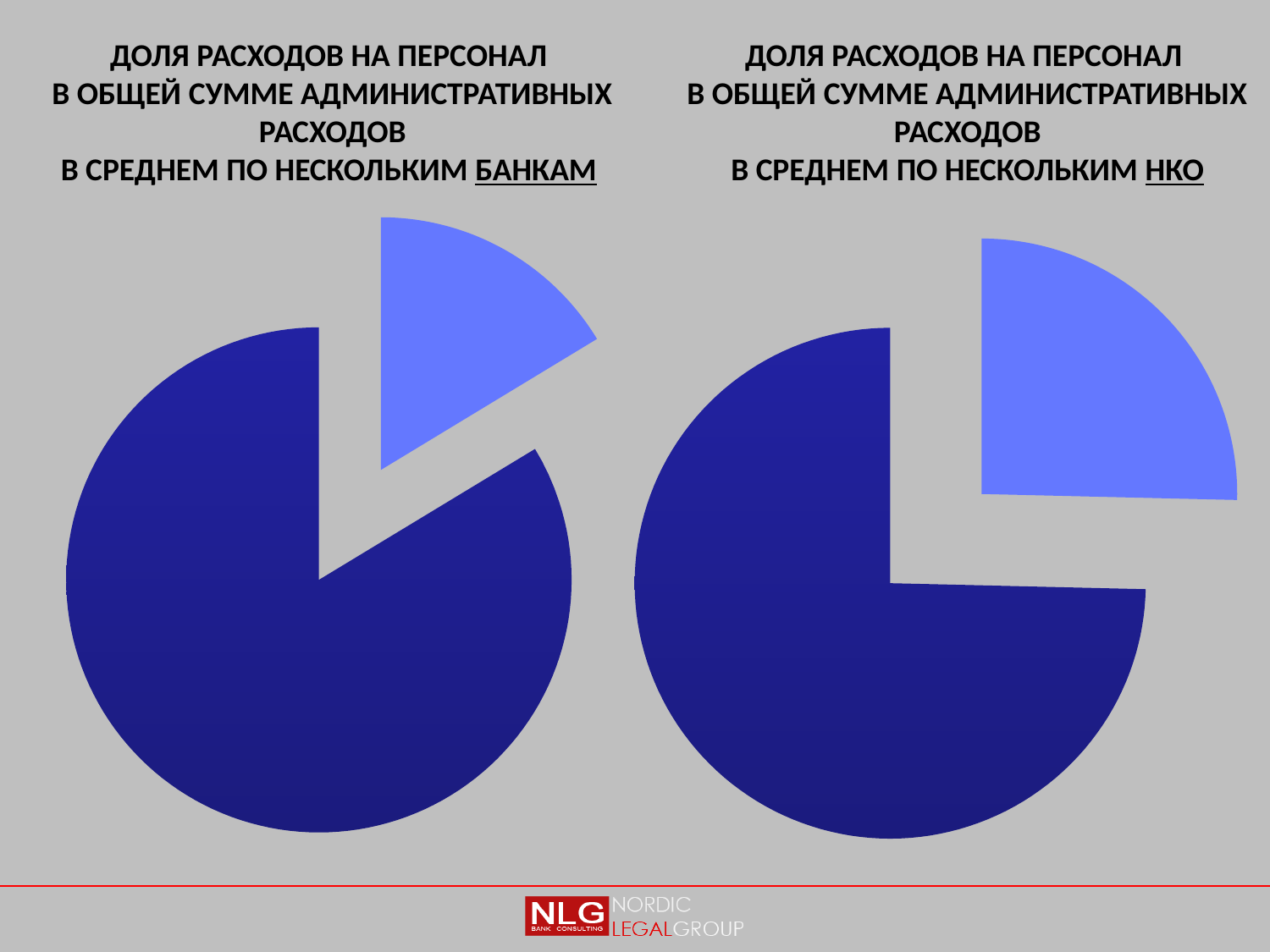
How many slices does the left pie chart (banks) have? 2 According to its title, the right pie chart shows the average for which type of organisation? НКО According to its title, the left pie chart shows the average for which type of organisation? Банкам (banks) In the left pie chart (banks), which slice is the smallest? The light blue slice What kind of chart is the left chart ("...В СРЕДНЕМ ПО НЕСКОЛЬКИМ БАНКАМ")? Pie chart What kind of chart is the right chart ("...В СРЕДНЕМ ПО НЕСКОЛЬКИМ НКО")? Pie chart In the left pie chart (banks), which slice is larger, the dark blue one or the light blue one? The dark blue one How many slices does the right pie chart (НКО) have? 2 In the right pie chart (НКО), which slice is larger, the dark blue one or the light blue one? The dark blue one In the right pie chart (НКО), which slice is the largest? The dark blue slice